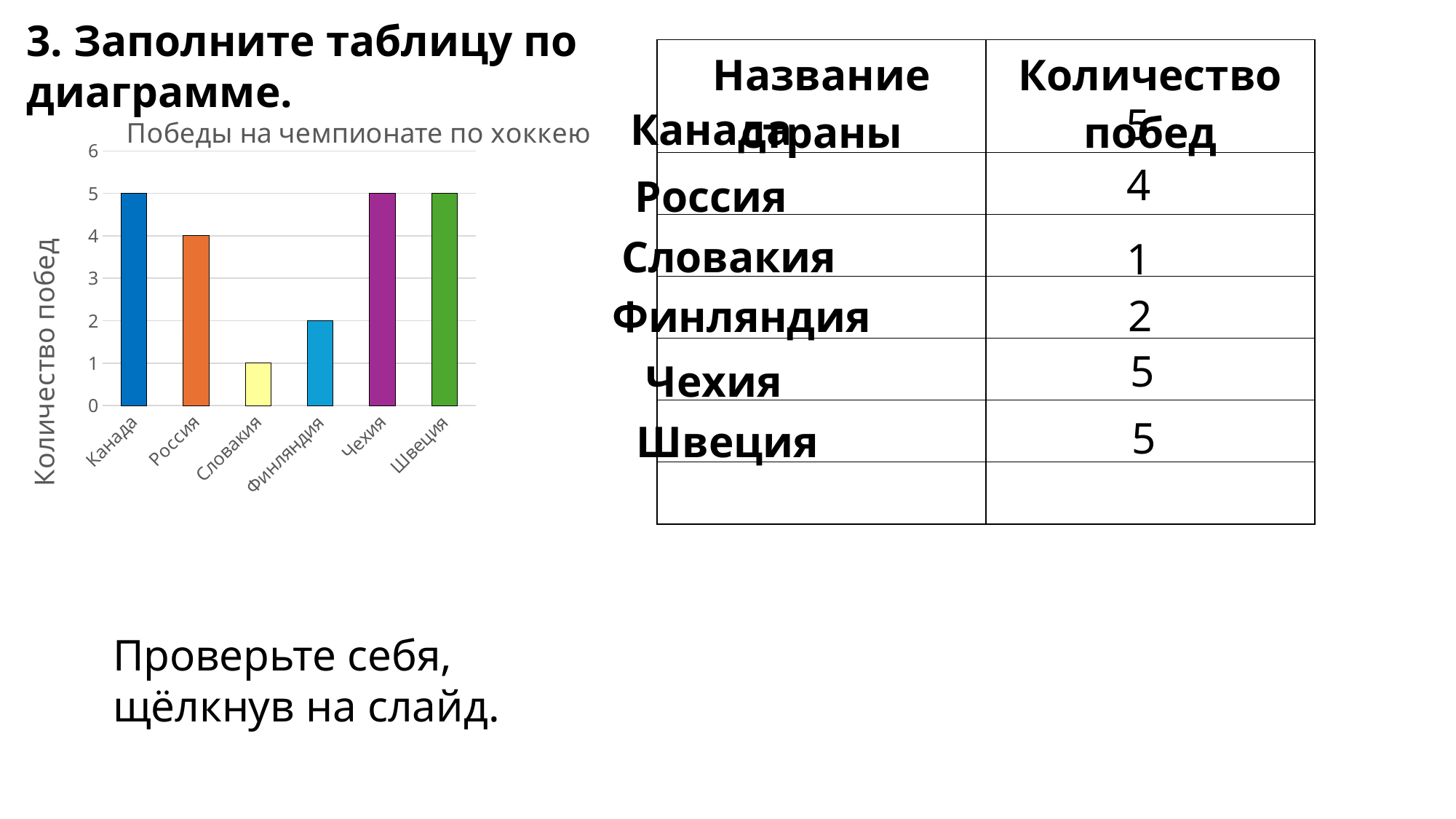
What kind of chart is shown on the slide? bar chart What is the value for Канада in the chart? 5 What is the title of the chart? Победы на чемпионате по хоккею Which country has the lowest value in the chart? Словакия What is the value for Россия in the chart? 4 Which has a larger value, Россия or Финляндия? Россия Is the value for Финляндия greater or less than 3? less How many countries are shown on the x axis of the chart? 6 What is the value for Словакия in the chart? 1 What is the value for Финляндия in the chart? 2 What is the difference between the values for Россия and Словакия? 3 What is the label on the vertical axis of the chart? Количество побед